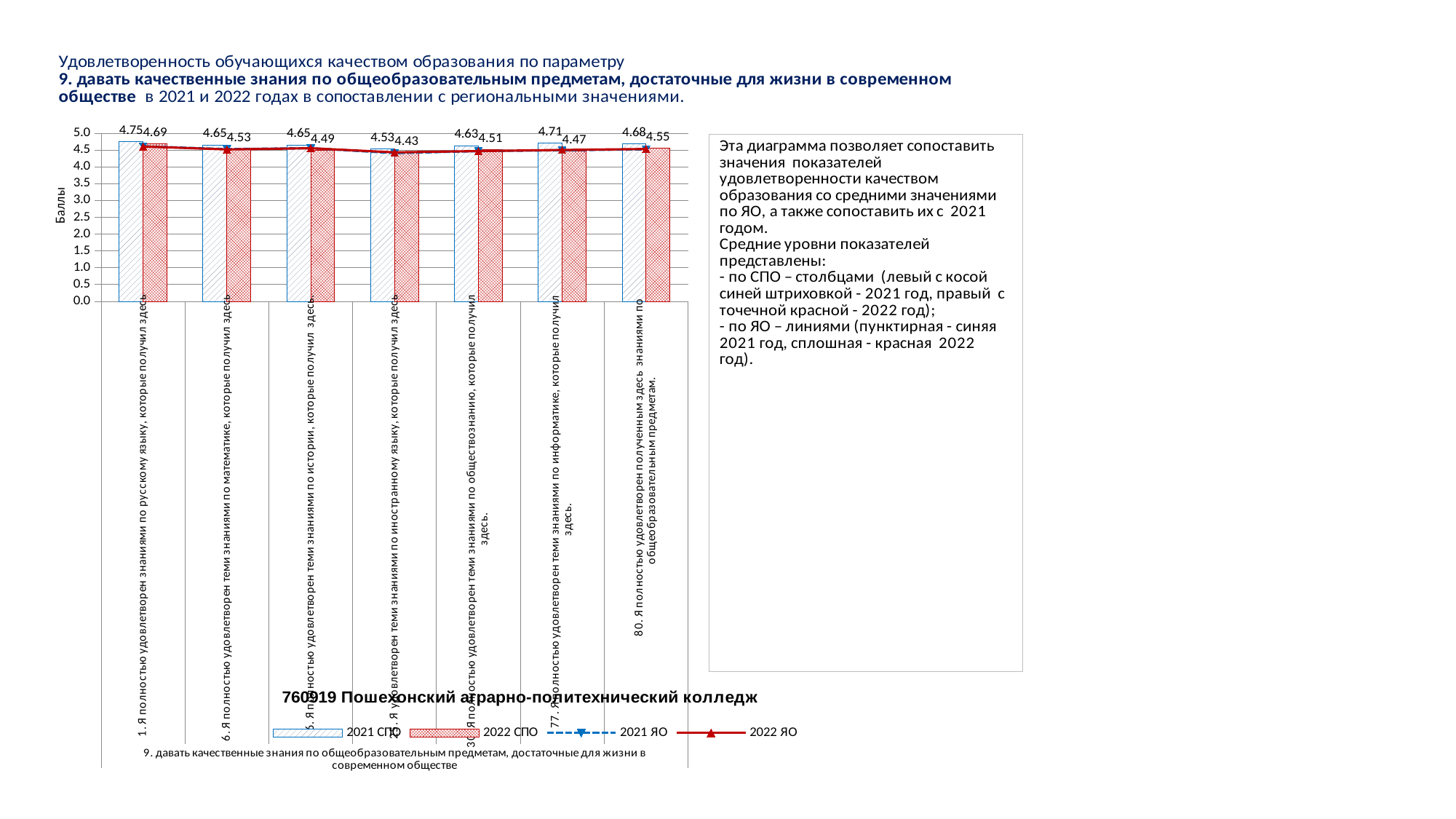
How many categories are shown on the x axis of the chart? 7 What is the 2021 СПО value for the category about knowledge of Russian language (русскому языку)? 4.75 Which category has the highest 2021 СПО value? 1. Я полностью удовлетворен знаниями по русскому языку, которые получил здесь Which is larger for the history (истории) category: the 2021 СПО value or the 2022 СПО value? 2021 СПО What is the 2021 СПО value for the category about knowledge of social studies (обществознанию)? 4.63 What kind of chart is shown on the slide? Combined bar and line chart What is the difference between the 2021 СПО and 2022 СПО values for the informatics (информатике) category? 0.24 What is the 2022 СПО value for the category about knowledge of mathematics (математике)? 4.53 How many series does the chart legend list? 4 What is the 2022 СПО value for the category about knowledge of informatics (информатике)? 4.47 What is the difference between the 2021 СПО and 2022 СПО values for the Russian language (русскому языку) category? 0.06 Which category has the lowest 2022 СПО value? Я удовлетворен теми знаниями по иностранному языку, которые получил здесь